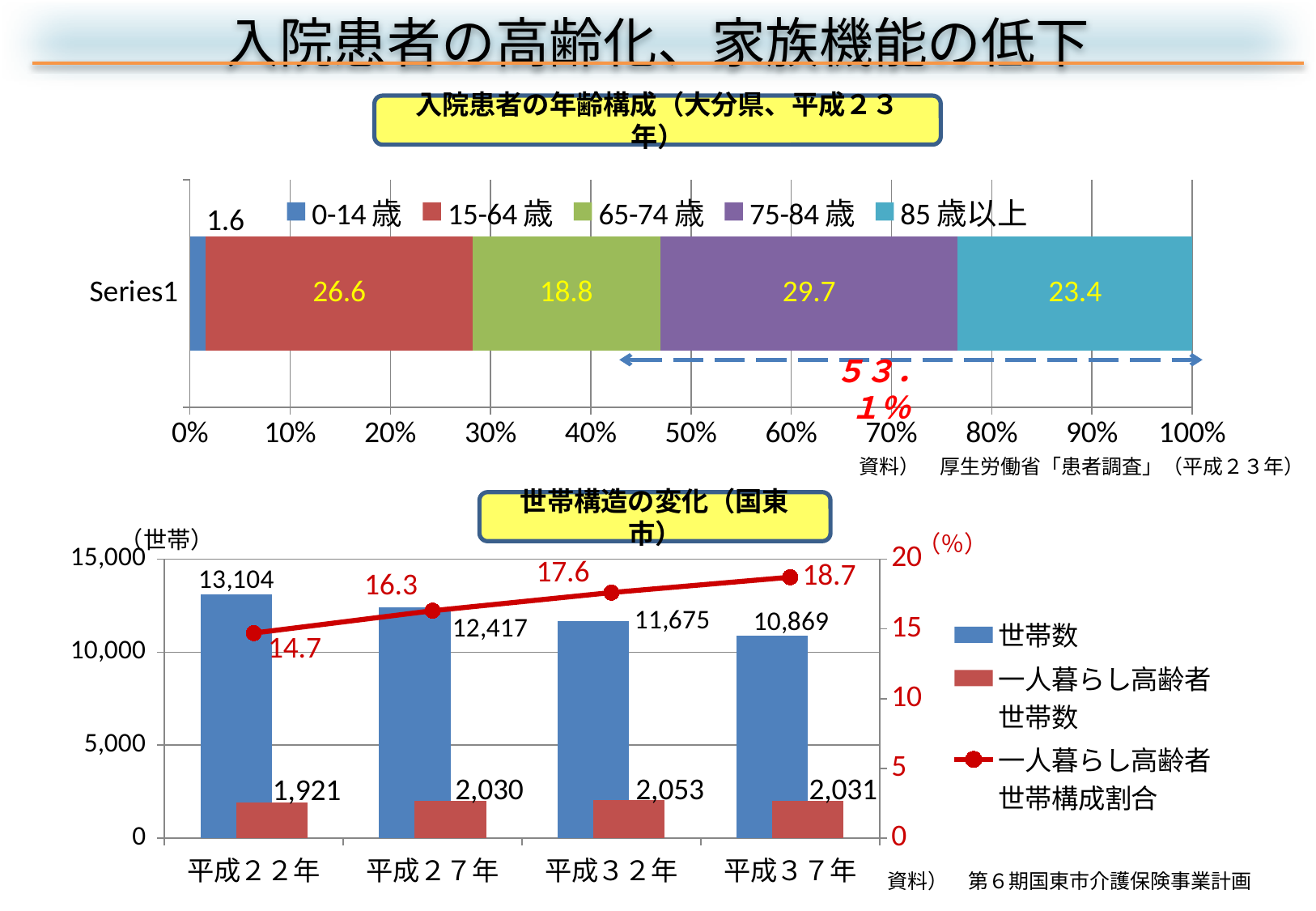
In the top chart (入院患者の年齢構成), what is the value for the 75-84歳 segment? 29.7 In the bottom chart (世帯構造の変化), what is the difference in 世帯数 between 平成２２年 and 平成３７年? 2,235 In the bottom chart (世帯構造の変化), what is the 一人暮らし高齢者世帯構成割合 for 平成３７年? 18.7 In the bottom chart (世帯構造の変化), does the 世帯数 rise or fall from 平成２２年 to 平成３７年? fall In the top chart (入院患者の年齢構成), which age group has the largest share? 75-84歳 In the top chart (入院患者の年齢構成), what is the difference between the 15-64歳 and 65-74歳 values? 7.8 In the top chart (入院患者の年齢構成), what is the value for the 0-14歳 segment? 1.6 In the bottom chart (世帯構造の変化), what is the 世帯数 value for 平成２２年? 13,104 In the top chart (入院患者の年齢構成), which age group has the smallest share? 0-14歳 In the bottom chart (世帯構造の変化), in which year is the 一人暮らし高齢者世帯数 highest? 平成３２年 In the bottom chart (世帯構造の変化), how many years are shown on the x axis? 4 In the top chart (入院患者の年齢構成), how many series does the legend list? 5